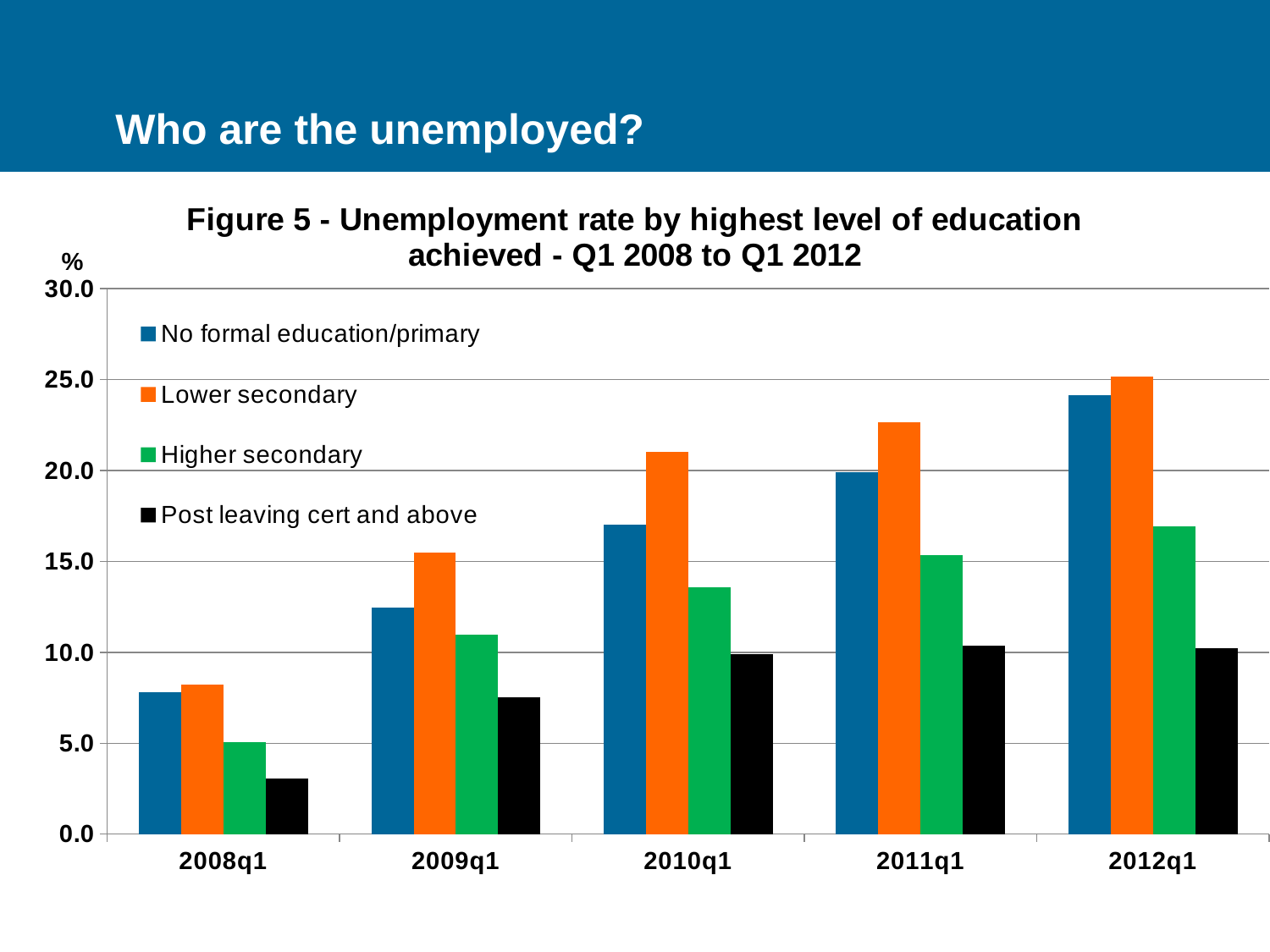
Which education level has the lowest unemployment rate in 2011q1? Post leaving cert and above How many series does the legend list? 4 How many time periods are shown on the x axis? 5 In which period is the unemployment rate for Lower secondary highest? 2012q1 Is the value for Lower secondary in 2010q1 greater or less than 20.0? greater What kind of chart is shown on the slide? bar chart What is the title of the chart? Figure 5 - Unemployment rate by highest level of education achieved - Q1 2008 to Q1 2012 Does the unemployment rate for No formal education/primary rise or fall from 2008q1 to 2012q1? rise Is the value for No formal education/primary in 2012q1 greater or less than 20.0? greater Is the value for Post leaving cert and above in 2008q1 greater or less than 5.0? less Which is larger: Lower secondary in 2010q1 or Higher secondary in 2011q1? Lower secondary in 2010q1